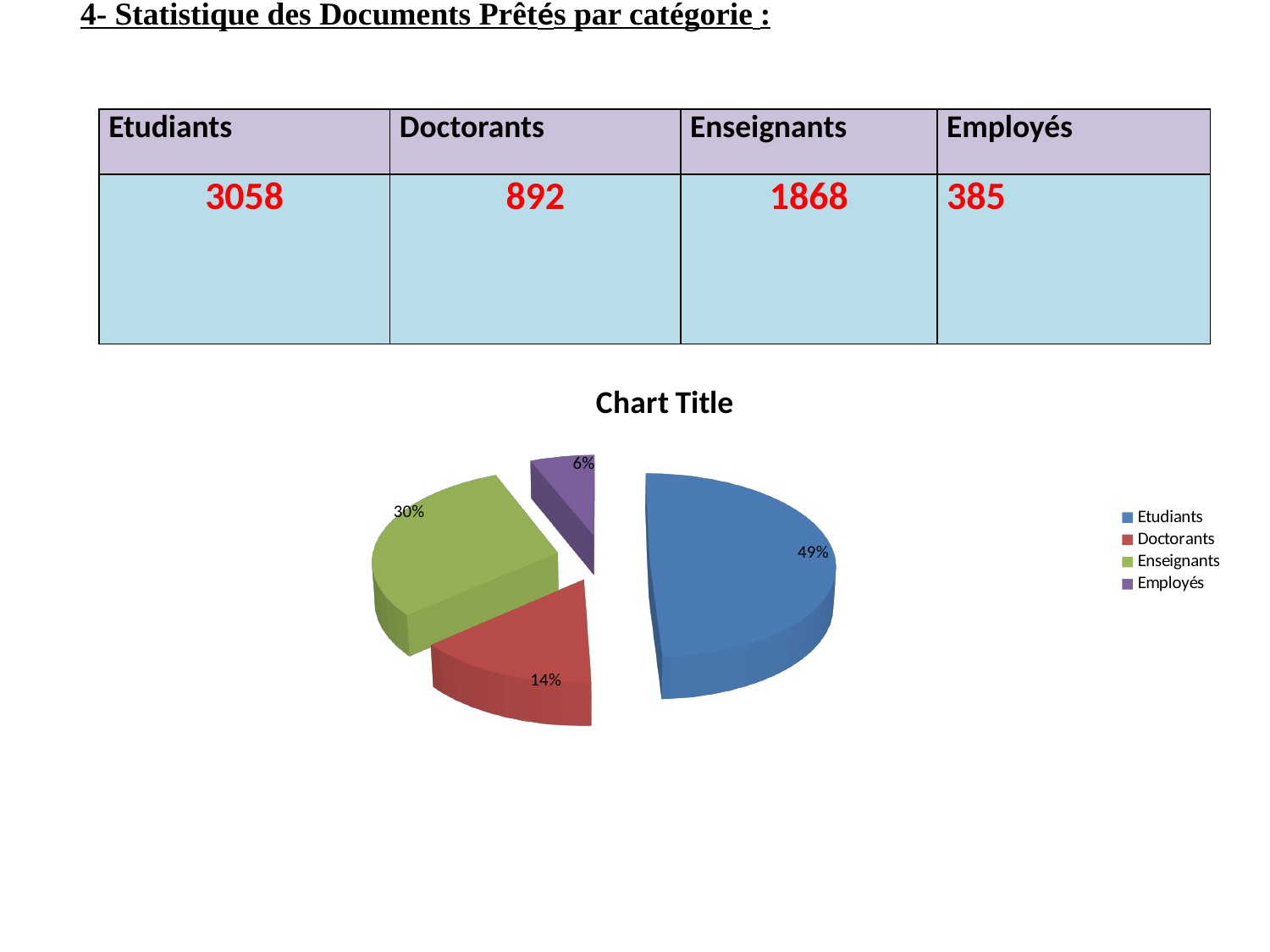
What percentage share does the Etudiants slice have in the pie chart? 49% What percentage share does the Doctorants slice have in the pie chart? 14% Which slice is larger in the pie chart, Enseignants or Doctorants? Enseignants What type of chart is shown on the slide? pie chart What percentage share does the Employés slice have in the pie chart? 6% Which category has the smallest slice in the pie chart? Employés What is the title shown above the pie chart? Chart Title What colour is the Enseignants slice in the pie chart? green How many categories does the legend of the pie chart list? 4 Which category has the largest slice in the pie chart? Etudiants What is the difference in percentage points between the Etudiants slice and the Enseignants slice? 19